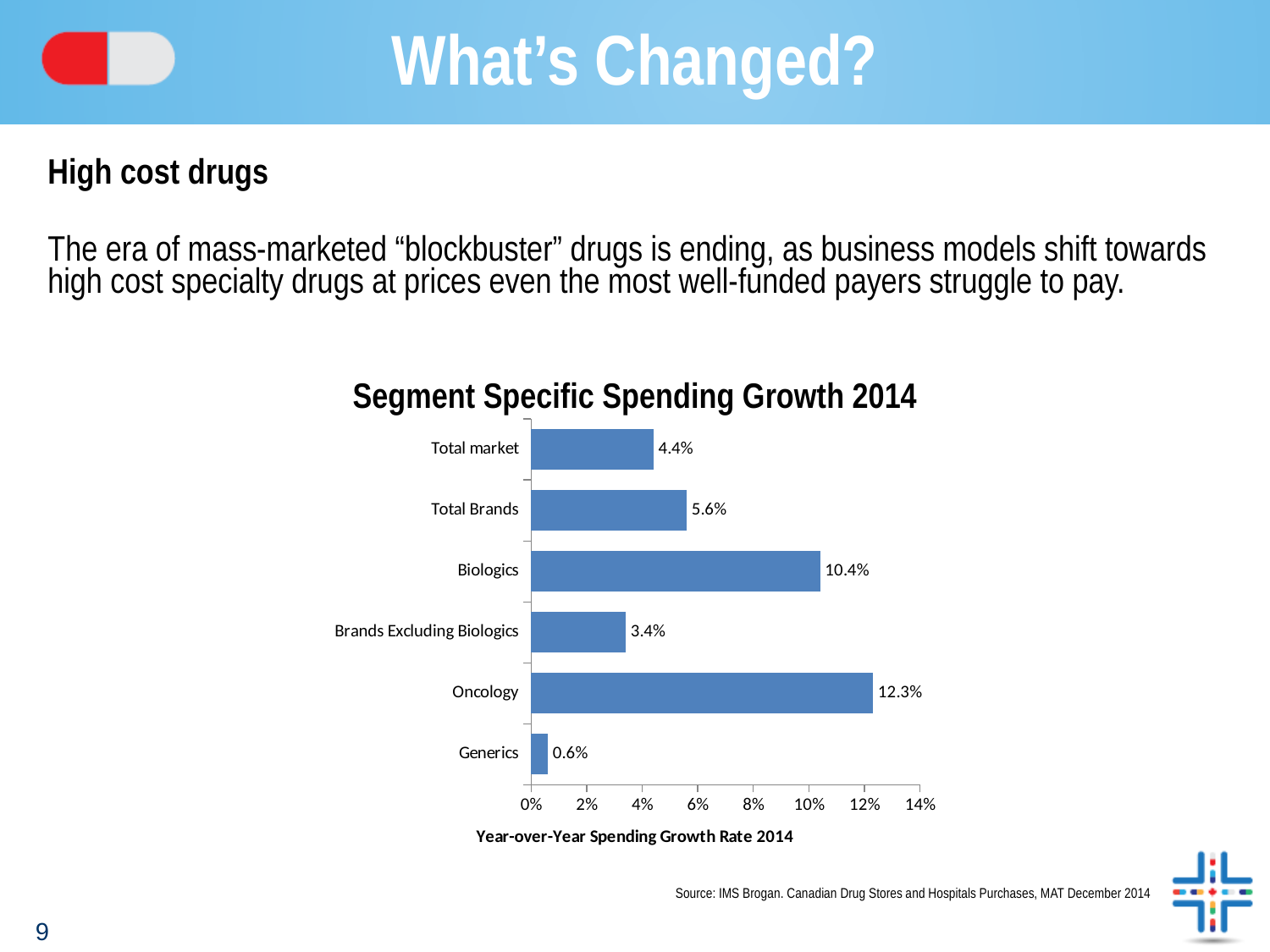
How many segments are shown in the chart? 6 Which segment has the lowest spending growth rate? Generics What is the spending growth rate for Generics? 0.6% What is the difference between the growth rates of Total Brands and Total market? 1.2% What is the title of the chart? Segment Specific Spending Growth 2014 Which segment has the highest spending growth rate? Oncology What is the spending growth rate for Biologics? 10.4% Is the value for Oncology greater or less than 10%? greater Which has a higher growth rate, Biologics or Brands Excluding Biologics? Biologics What is the spending growth rate for Brands Excluding Biologics? 3.4% What type of chart is shown on the slide? Bar chart What is the spending growth rate for Oncology? 12.3%